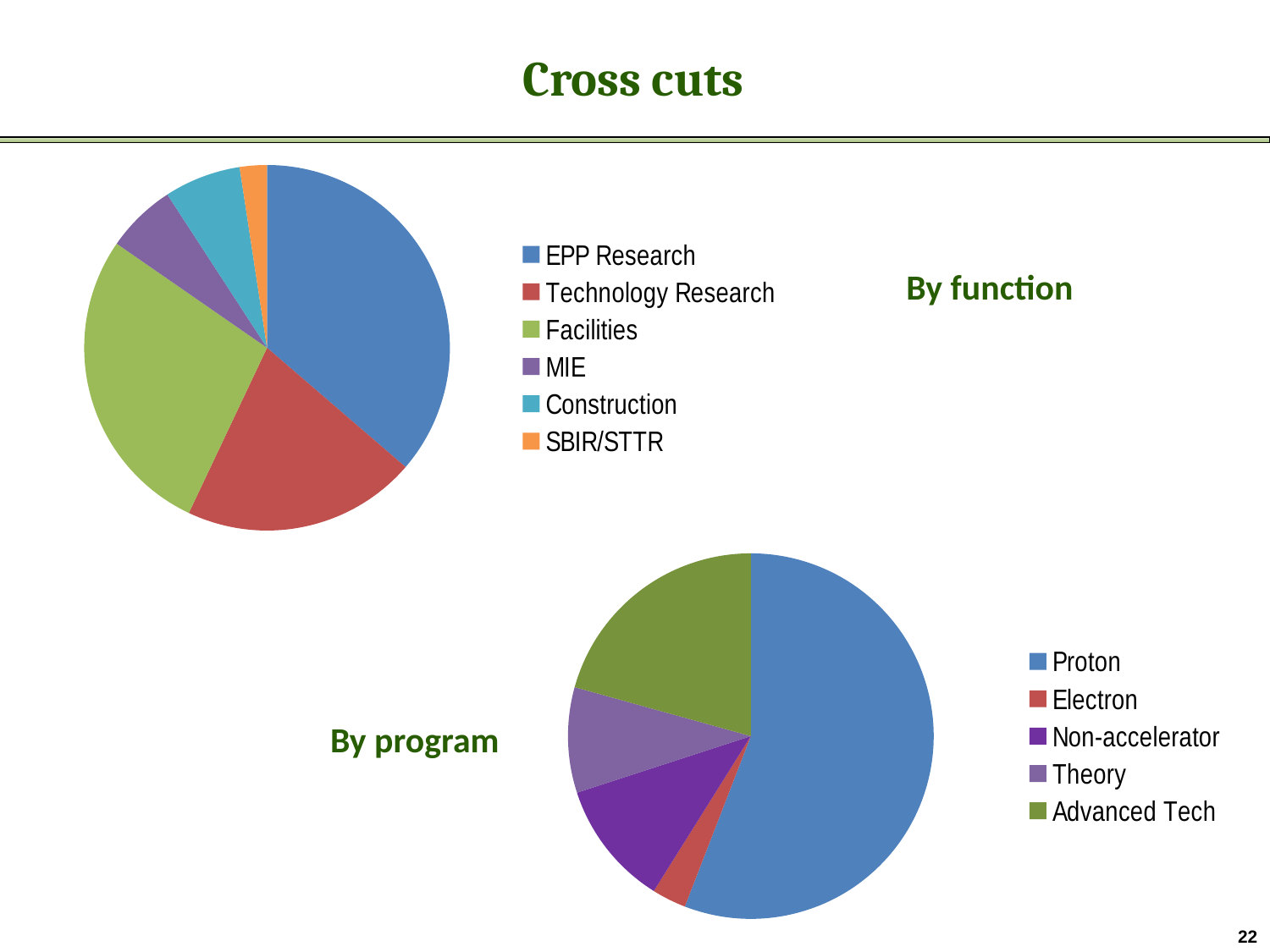
In the "By program" chart, how many categories does the legend list? 5 In the "By program" chart, which slice is larger, Advanced Tech or Non-accelerator? Advanced Tech In the "By function" chart, which slice is larger, Facilities or Technology Research? Facilities In the "By program" chart, which category has the largest slice? Proton What is the title of the slide containing the two pie charts? Cross cuts What kind of chart is the "By function" chart? pie chart In the "By function" chart, how many categories does the legend list? 6 In the "By function" chart, which category has the largest slice? EPP Research What kind of chart is the "By program" chart? pie chart In the "By function" chart, what colour is the Construction slice? teal In the "By program" chart, which category has the smallest slice? Electron In the "By function" chart, which category has the smallest slice? SBIR/STTR